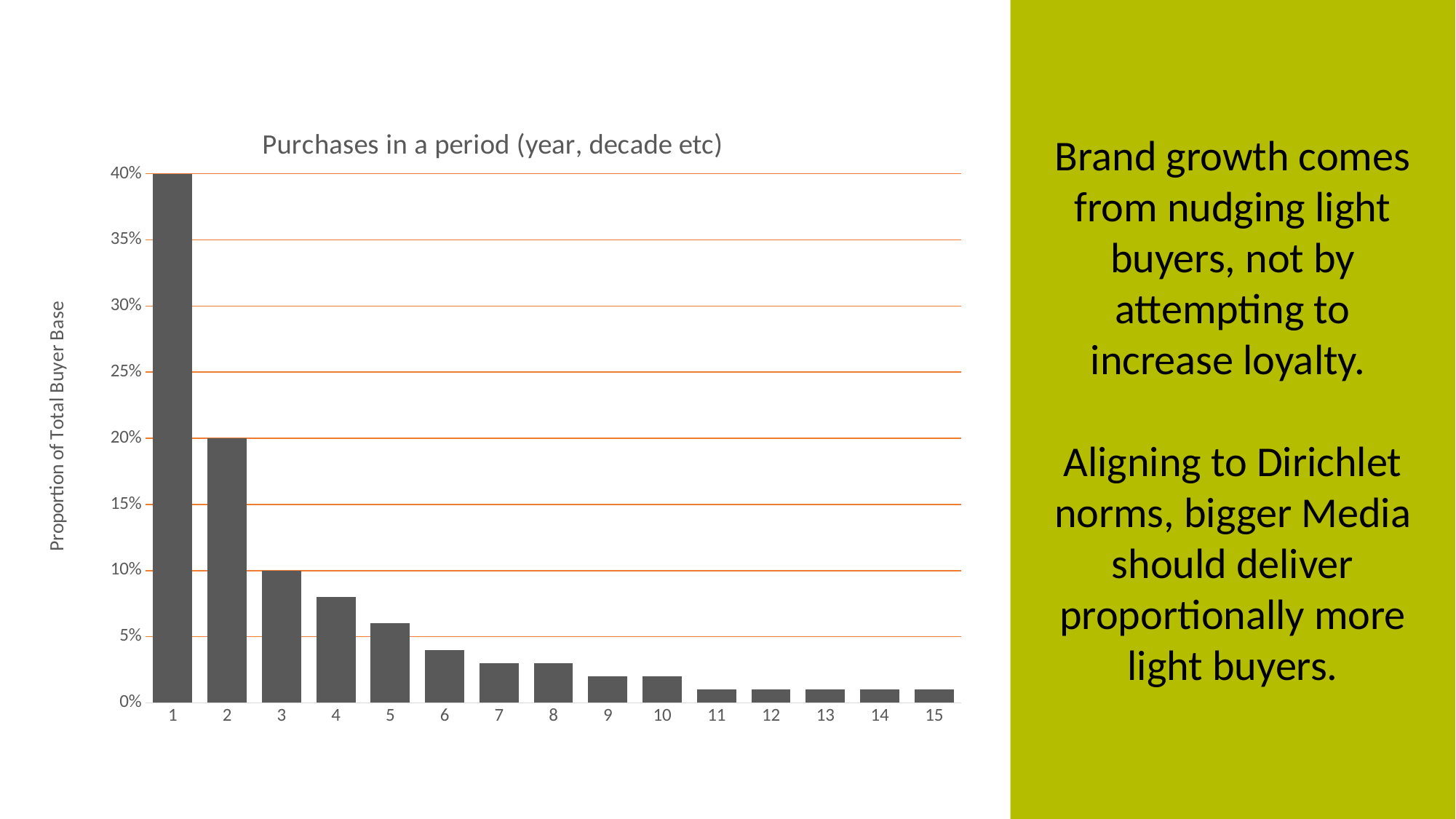
Is the value for category 4 greater or less than 5%? greater Which has a larger value, category 4 or category 5? Category 4 Which category has the highest proportion of the total buyer base? 1 What is the proportion of the total buyer base for category 3? 10% What is the label on the vertical axis of the chart? Proportion of Total Buyer Base What is the proportion of the total buyer base for category 1? 40% Do the values rise or fall as you move from category 1 to category 15 along the x axis? Fall What is the title of the chart? Purchases in a period (year, decade etc) What is the proportion of the total buyer base for category 2? 20% What type of chart is shown on the slide? Bar chart What is the difference between the values for category 1 and category 2? 20% How many categories are shown along the x axis of the chart? 15